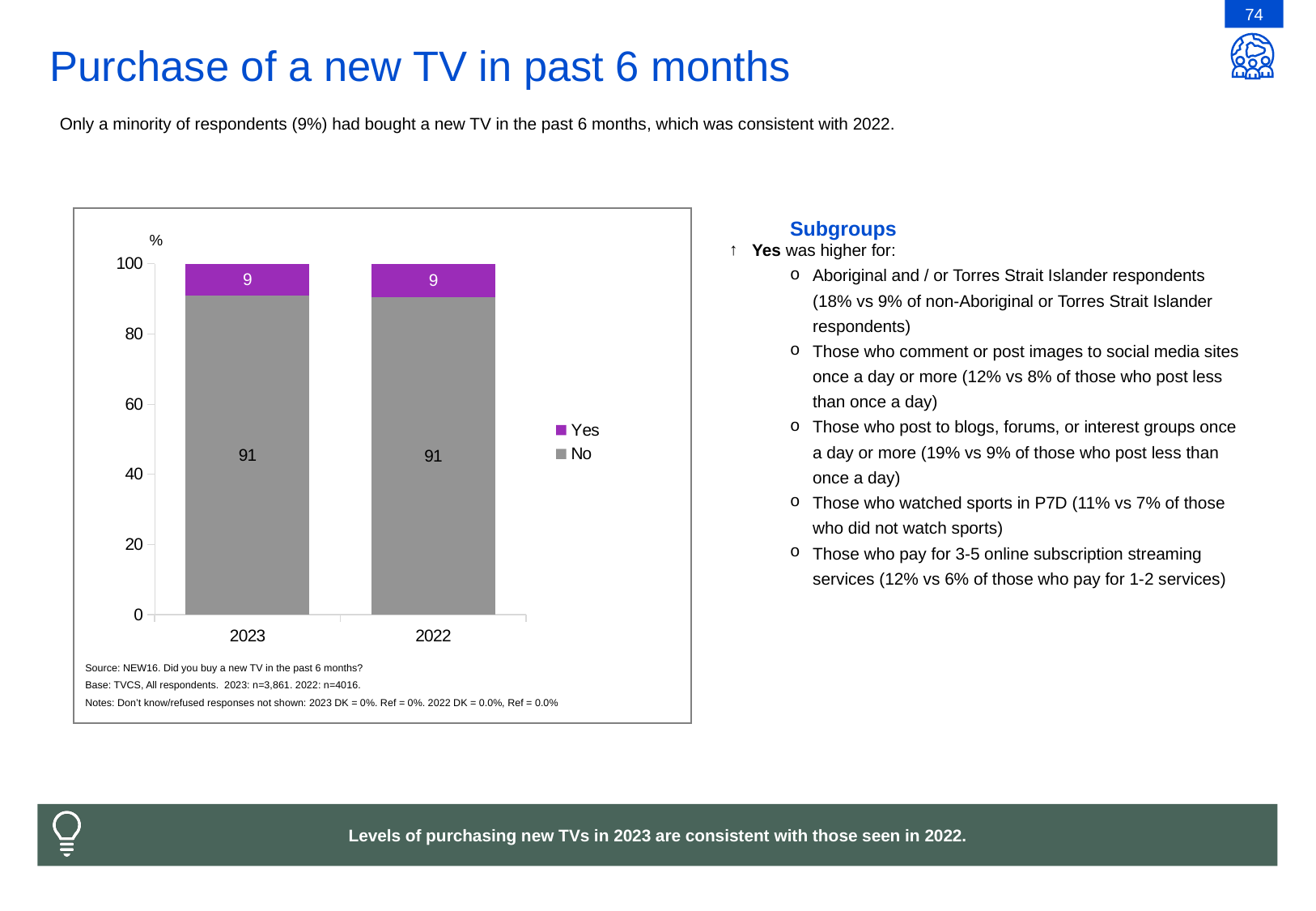
What is the value for No in 2023? 91 What is the difference between the No and Yes values in 2023? 82 What is the value for Yes in 2023? 9 What kind of chart is shown on the slide? Stacked bar chart What is the value for Yes in 2022? 9 What is the value for No in 2022? 91 Does the Yes value change between 2023 and 2022? No, it stays at 9 How many series does the legend list? 2 Which is larger in 2022, the Yes value or the No value? No What is the total of the stacked bar for 2023? 100 Which colour represents the Yes series in the legend? Purple How many categories are shown on the x axis? 2